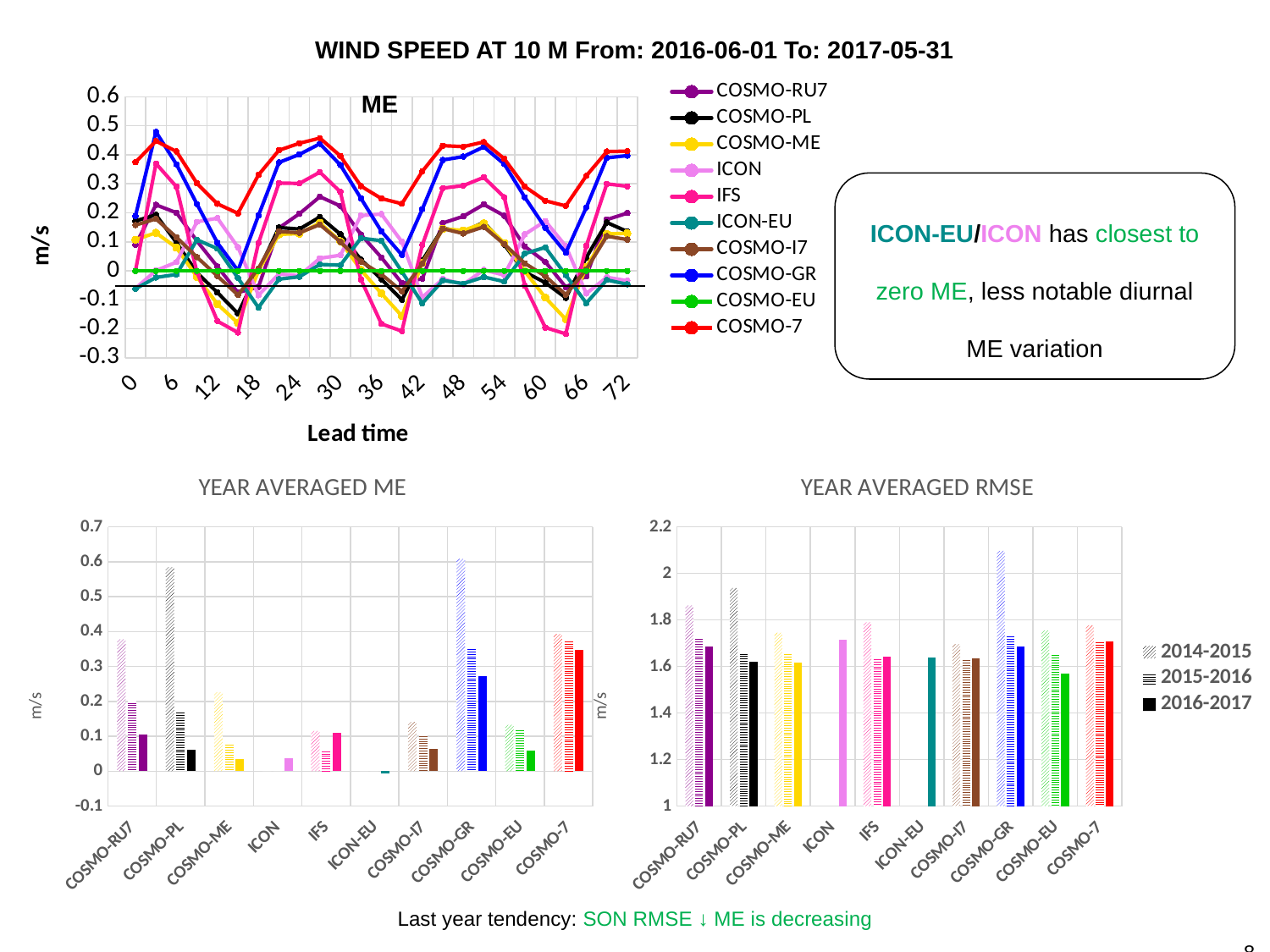
In the "YEAR AVERAGED ME" chart, is the 2014-2015 value for COSMO-PL greater or less than 0.5? greater What kind of chart is the "YEAR AVERAGED ME" chart? bar chart How many series does the legend of the "YEAR AVERAGED RMSE" chart list? 3 In the "YEAR AVERAGED ME" chart, which model has the highest 2016-2017 value? COSMO-7 How many series does the legend of the top "ME" line chart list? 10 What kind of chart is the top chart titled "ME"? line chart What is the x-axis title of the top "ME" line chart? Lead time In the "YEAR AVERAGED RMSE" chart, is the 2014-2015 value for COSMO-PL greater or less than 1.8? greater How many model categories are shown on the x axis of the "YEAR AVERAGED ME" chart? 10 In the "YEAR AVERAGED RMSE" chart, which is larger for 2016-2017: COSMO-EU or COSMO-7? COSMO-7 In the "YEAR AVERAGED RMSE" chart, which model has the highest 2014-2015 value? COSMO-GR